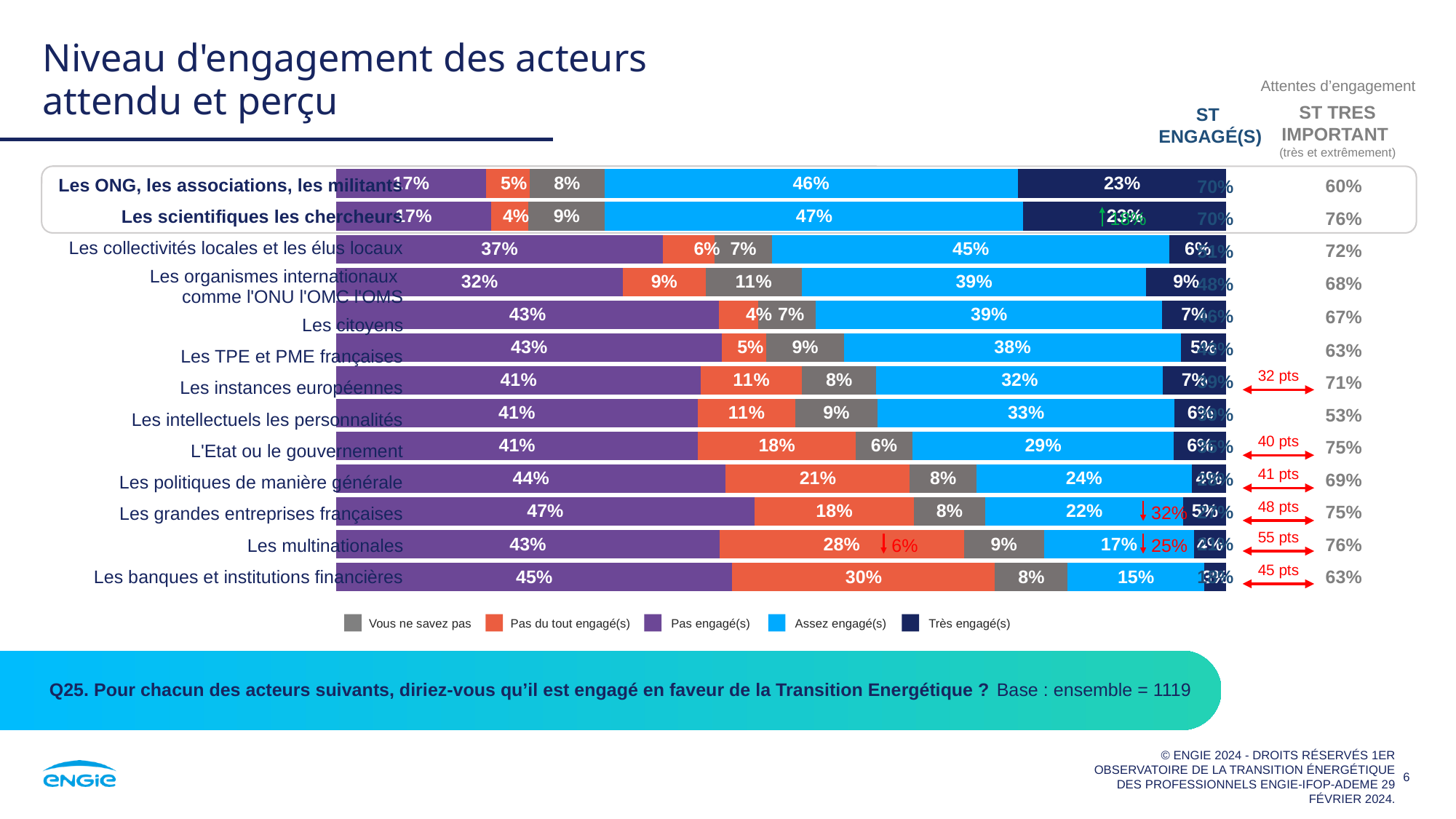
How many actor categories are plotted in the chart? 13 What is the difference between the 'Assez engagé(s)' values for 'Les ONG, les associations, les militants' and 'Les banques et institutions financières'? 31 points Which actor has the highest 'Pas du tout engagé(s)' value? Les banques et institutions financières Which legend entry is shown in dark navy blue? Très engagé(s) Which has the larger 'Pas du tout engagé(s)' value: 'L'Etat ou le gouvernement' or 'Les instances européennes'? L'Etat ou le gouvernement What is the 'Pas engagé(s)' value for 'Les grandes entreprises françaises'? 47% How many series does the chart legend list? 5 What is the 'Assez engagé(s)' value for 'Les scientifiques les chercheurs'? 47% What kind of chart is shown on the slide? Stacked bar chart What is the 'Pas du tout engagé(s)' value for 'Les banques et institutions financières'? 30% What is the 'Très engagé(s)' value for 'Les ONG, les associations, les militants'? 23% Which actor has the lowest 'Assez engagé(s)' value? Les banques et institutions financières